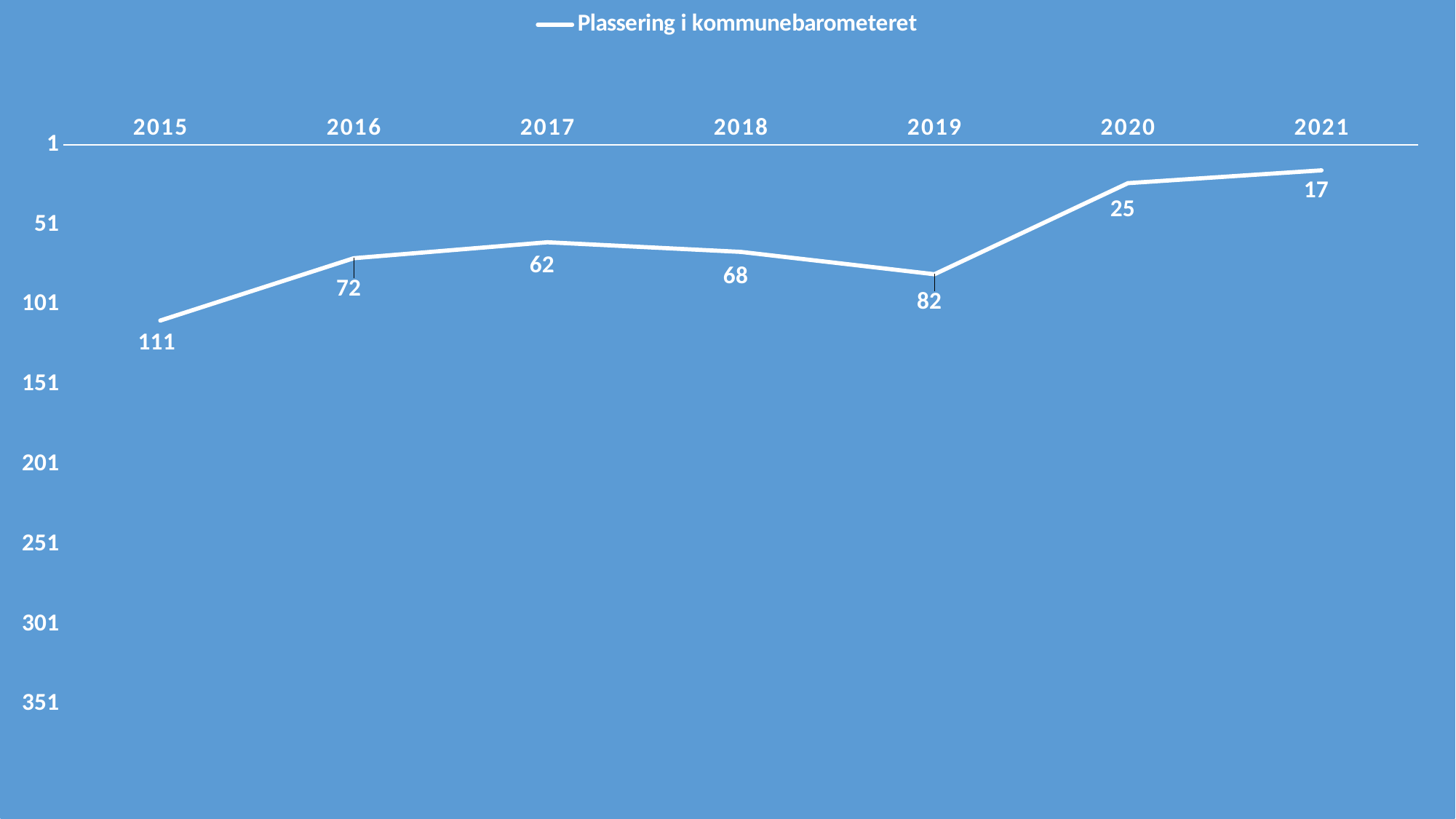
Which year has the lowest plotted value? 2021 How many series does the legend list? 1 Which year has the highest plotted value? 2015 What is the value for 2019? 82 What is the difference between the values for 2019 and 2020? 57 How many years are plotted on the x axis? 7 What is the value for 2015? 111 What is the difference between the values for 2015 and 2016? 39 What is the value for 2021? 17 What kind of chart is shown? line chart What is the name of the series shown in the legend? Plassering i kommunebarometeret Which is larger, the value for 2017 or the value for 2018? 2018